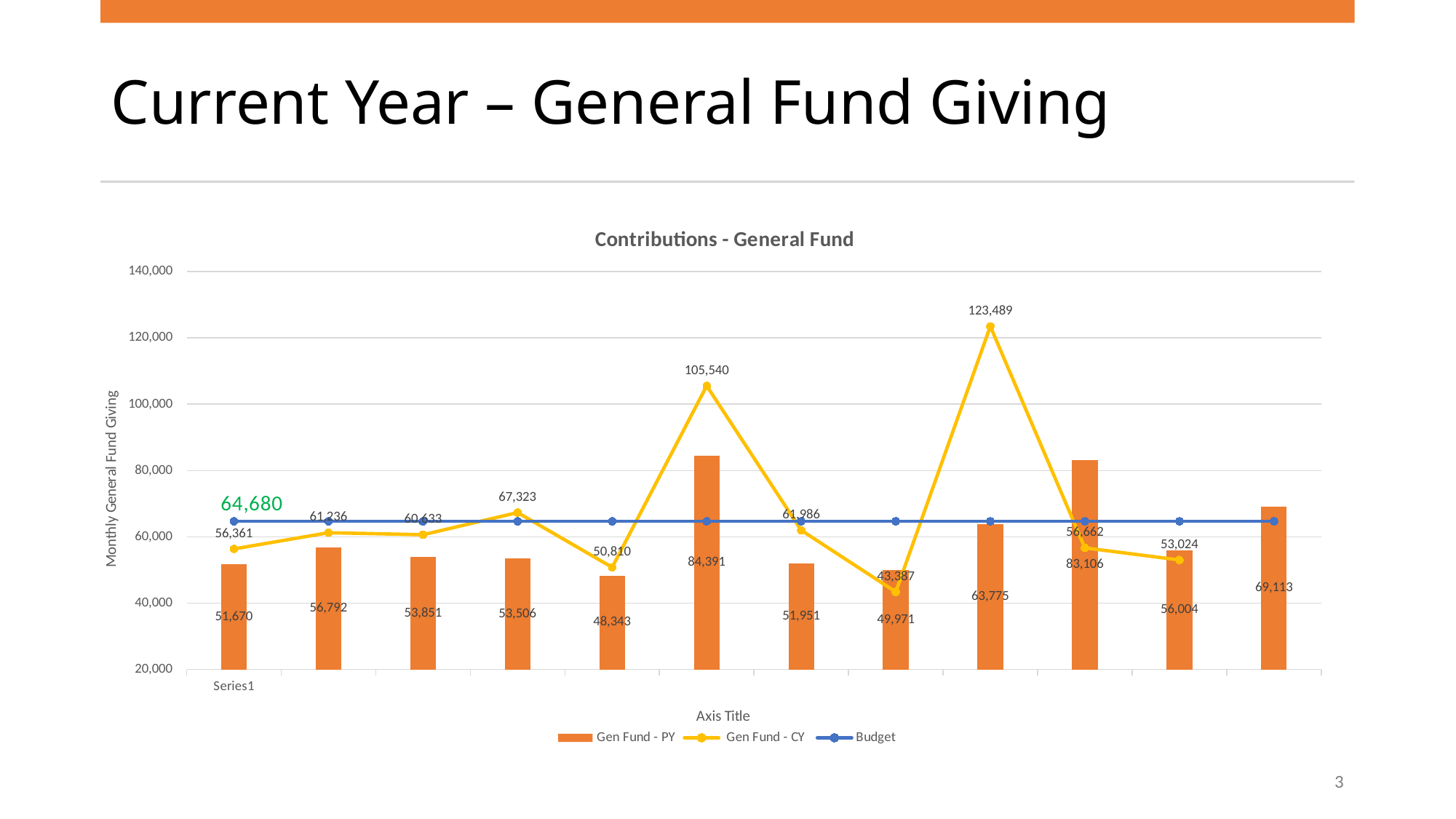
What is the title of the chart? Contributions - General Fund What is the lowest Gen Fund - PY bar value? 48,343 How many bars are plotted for the Gen Fund - PY series? 12 Is the highest point on the Gen Fund - CY line greater or less than 120,000? greater What is the Gen Fund - CY value for the category labelled Series1? 56,361 What is the Gen Fund - PY value for the category labelled Series1? 51,670 What is the value of the Budget line shown on the chart? 64,680 How many series does the chart legend list? 3 What kind of chart is shown on the slide? Combined bar and line chart What is the highest value on the Gen Fund - CY line? 123,489 What is the lowest value on the Gen Fund - CY line? 43,387 What is the highest Gen Fund - PY bar value? 84,391